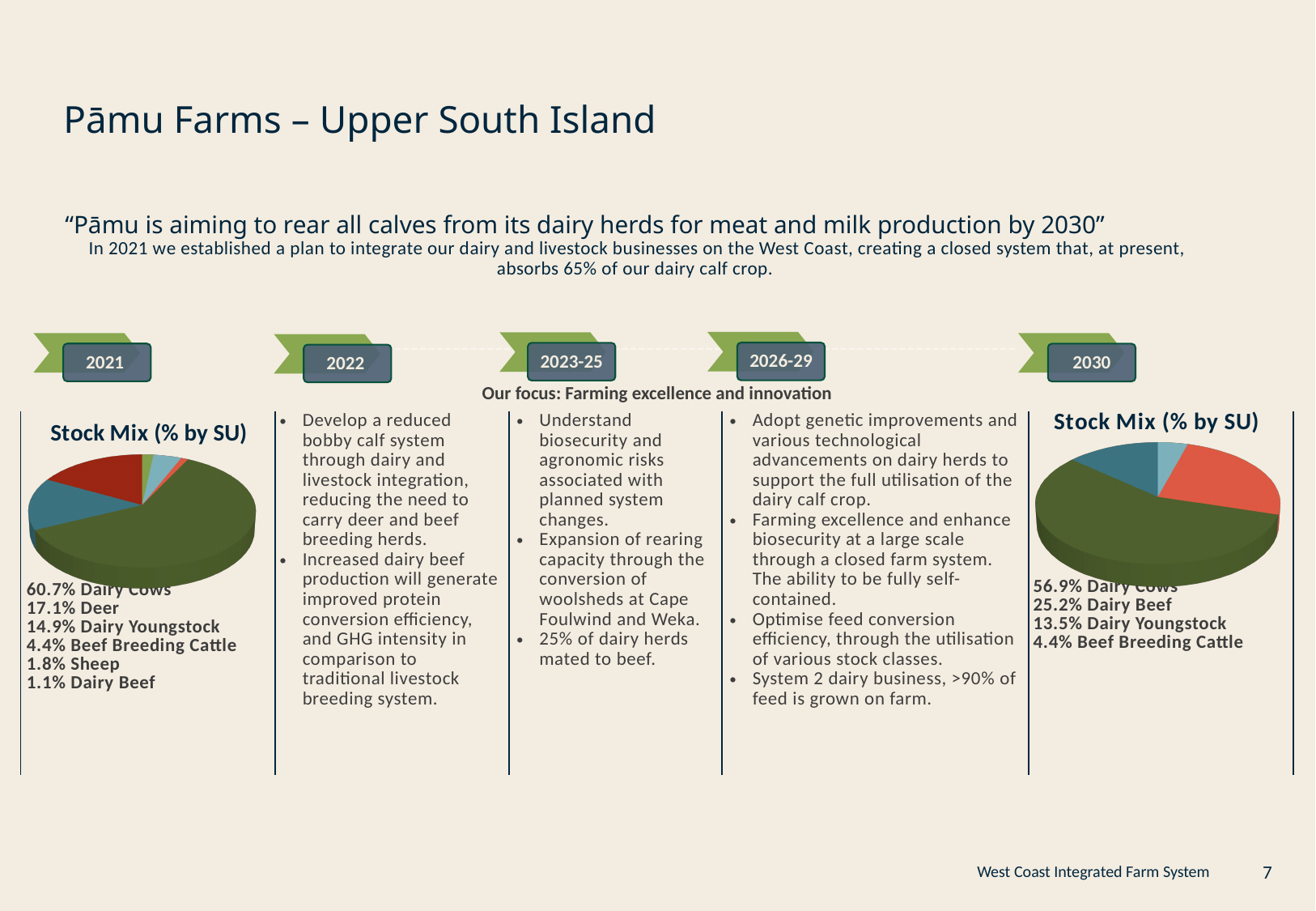
How many categories are shown in the 2021 Stock Mix (% by SU) chart? 6 In the 2021 Stock Mix (% by SU) chart, what share is Deer? 17.1% In the 2030 Stock Mix (% by SU) chart, which category has the largest share? Dairy Cows What is the title of the pie chart on the left of the slide? Stock Mix (% by SU) What type of chart is used for the 2021 Stock Mix (% by SU)? Pie chart In the 2021 Stock Mix (% by SU) chart, which category has the smallest share? Dairy Beef How many categories are shown in the 2030 Stock Mix (% by SU) chart? 4 What is the difference between the Dairy Cows share in the 2021 chart and the Dairy Cows share in the 2030 chart? 3.8% In the 2021 Stock Mix (% by SU) chart, what share is Dairy Cows? 60.7% In the 2021 Stock Mix (% by SU) chart, what is the difference between the Dairy Cows share and the Deer share? 43.6% Which is larger in the 2030 Stock Mix (% by SU) chart: Dairy Beef or Dairy Youngstock? Dairy Beef In the 2030 Stock Mix (% by SU) chart, what share is Dairy Beef? 25.2%